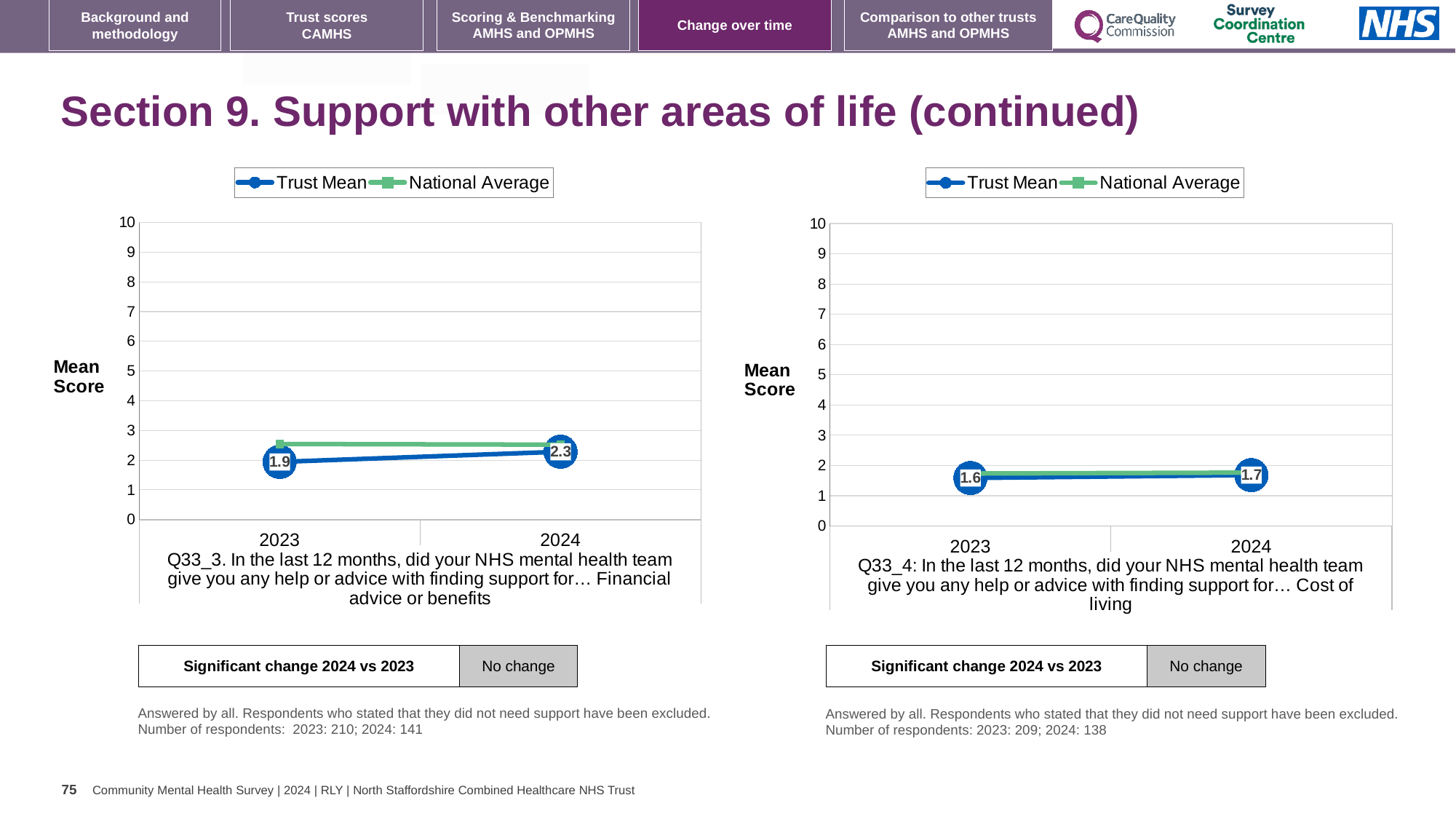
On the left chart (Q33_3), is the National Average for 2023 greater or less than 2? greater On the left chart (Q33_3), does the Trust Mean rise or fall from 2023 to 2024? rise On the left chart (Q33_3, Financial advice or benefits), what is the Trust Mean for 2023? 1.9 How many years are plotted on the x axis of the right chart (Q33_4)? 2 On the right chart (Q33_4, Cost of living), what is the Trust Mean for 2023? 1.6 On the left chart (Q33_3), by how much did the Trust Mean change from 2023 to 2024? 0.4 On the right chart (Q33_4, Cost of living), what is the Trust Mean for 2024? 1.7 On the right chart (Q33_4), what is the difference between the Trust Mean for 2024 and 2023? 0.1 What kind of chart is the right chart (Q33_4, Cost of living)? line chart On the left chart (Q33_3, Financial advice or benefits), what is the Trust Mean for 2024? 2.3 On the left chart (Q33_3), which year has the higher Trust Mean, 2023 or 2024? 2024 How many series does the legend of the left chart list? 2